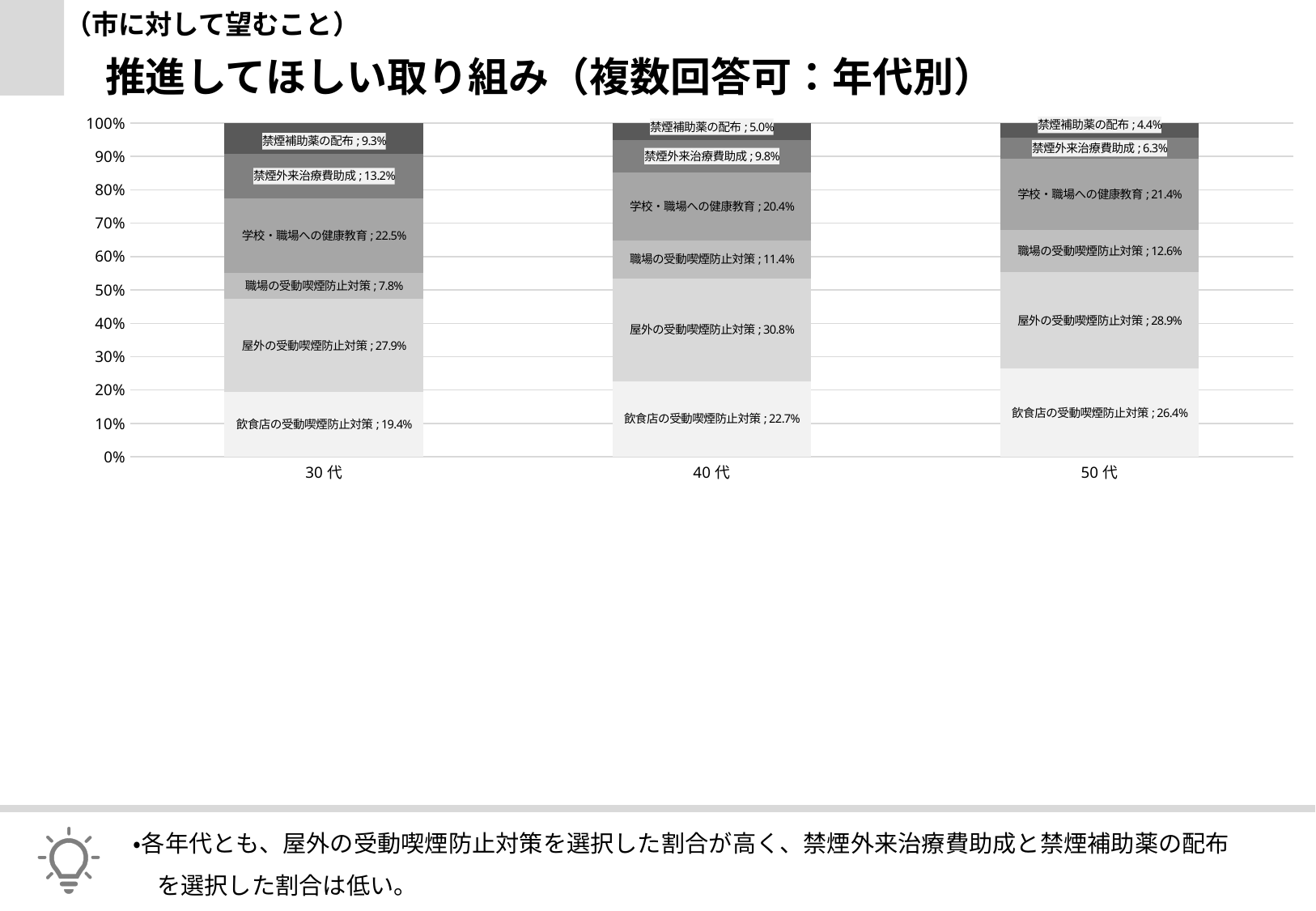
Which item has the smallest share in the 40代 bar? 禁煙補助薬の配布 What is the title of the chart? 推進してほしい取り組み（複数回答可：年代別） What is the value for 屋外の受動喫煙防止対策 in the 40代 bar? 30.8% Which age group has the larger value for 職場の受動喫煙防止対策, 30代 or 50代? 50代 What is the value for 飲食店の受動喫煙防止対策 in the 50代 bar? 26.4% What type of chart is shown on the slide? Stacked bar chart What is the difference between 屋外の受動喫煙防止対策 and 飲食店の受動喫煙防止対策 in the 30代 bar? 8.5% What is the value for 禁煙補助薬の配布 in the 50代 bar? 4.4% How many age groups are shown on the x axis? 3 What is the value for 禁煙外来治療費助成 in the 30代 bar? 13.2% Which item has the largest share in the 30代 bar? 屋外の受動喫煙防止対策 Which age group has the larger value for 禁煙外来治療費助成, 40代 or 50代? 40代